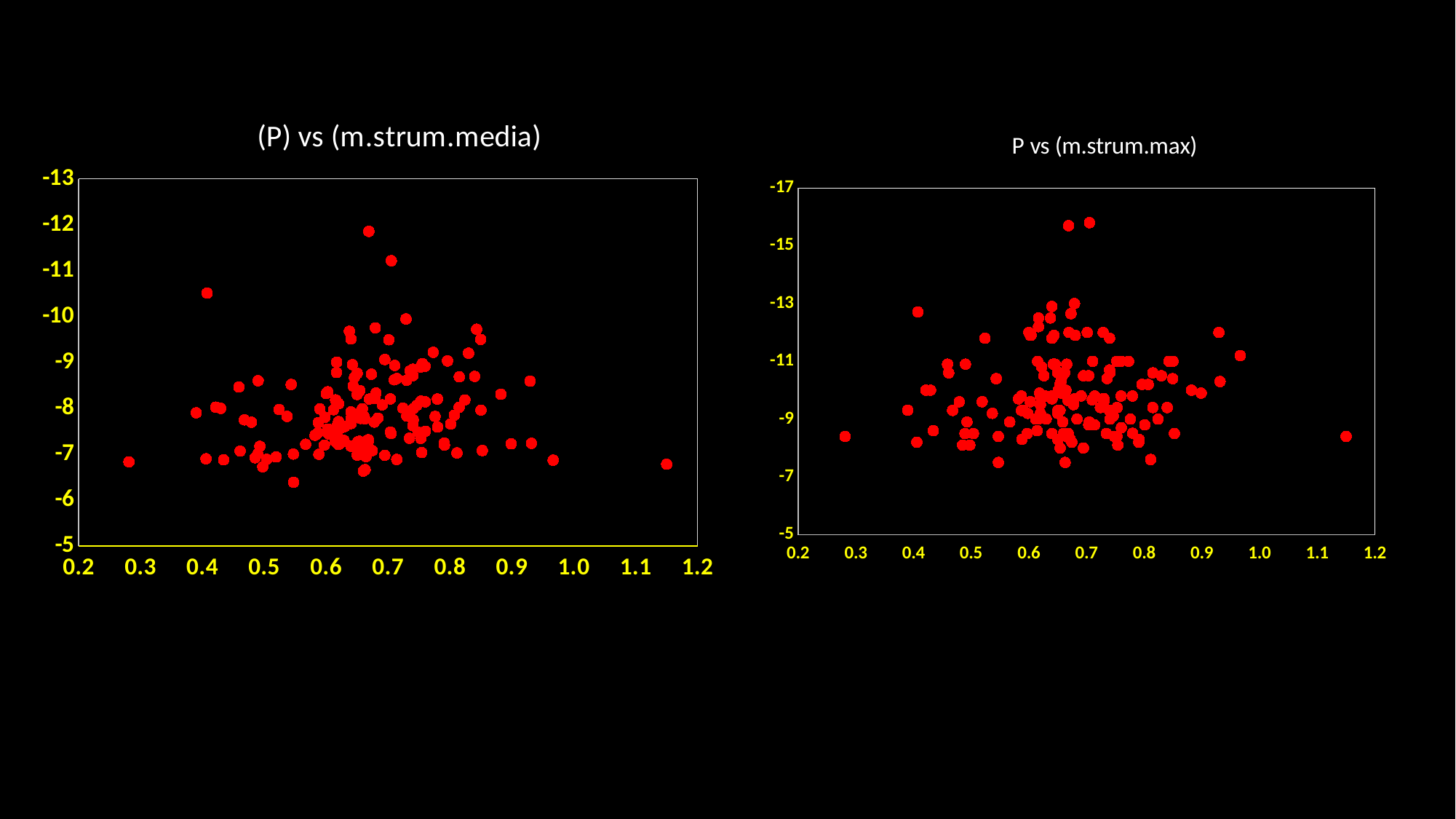
What kind of chart is the left chart titled "(P) vs (m.strum.media)"? scatter chart What is the title of the chart on the left of the slide? (P) vs (m.strum.media) In the left chart "(P) vs (m.strum.media)", is the x value of the rightmost point greater or less than 1.1? greater In the left chart "(P) vs (m.strum.media)", is the x value of the leftmost point greater or less than 0.3? less What is the title of the chart on the right of the slide? P vs (m.strum.max) What kind of chart is the right chart titled "P vs (m.strum.max)"? scatter chart In the right chart "P vs (m.strum.max)", is the x value of the rightmost point greater or less than 1.1? greater